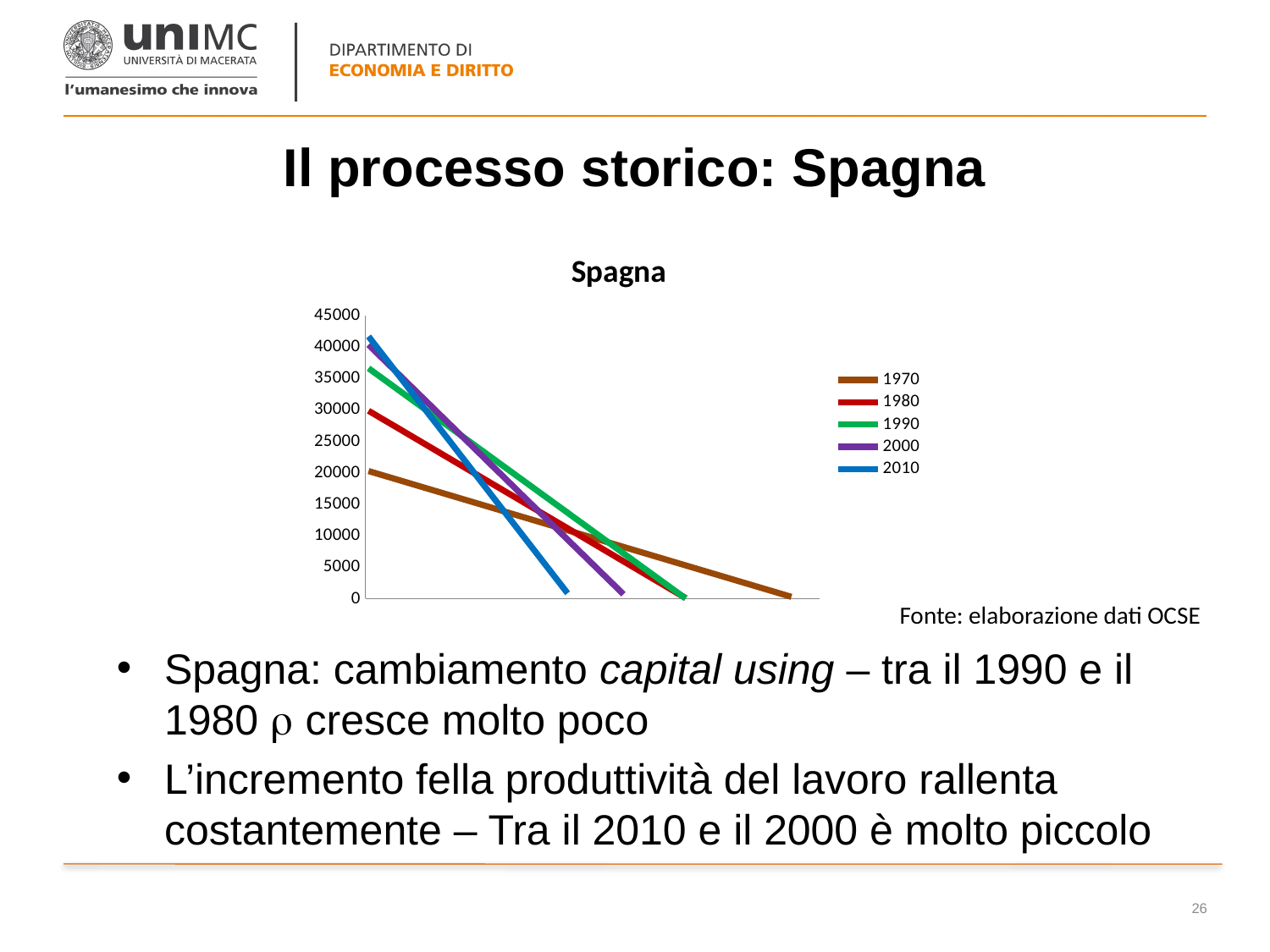
What is the title of the chart? Spagna At the left edge of the chart, which line is higher: 2010 or 1970? 2010 Which series starts at the highest value on the left side of the chart? 2010 Which series' line extends furthest to the right before reaching zero? 1970 Is the starting value of the 1990 line greater or less than 30000? greater Do the lines in the chart rise or fall from left to right? fall What kind of chart is shown on the slide? line chart Is the starting value of the 1980 line greater or less than 25000? greater Is the starting value of the 2010 line greater or less than 35000? greater Which series starts at the lowest value on the left side of the chart? 1970 How many series does the legend of the chart list? 5 Which years are listed in the chart's legend? 1970, 1980, 1990, 2000, 2010